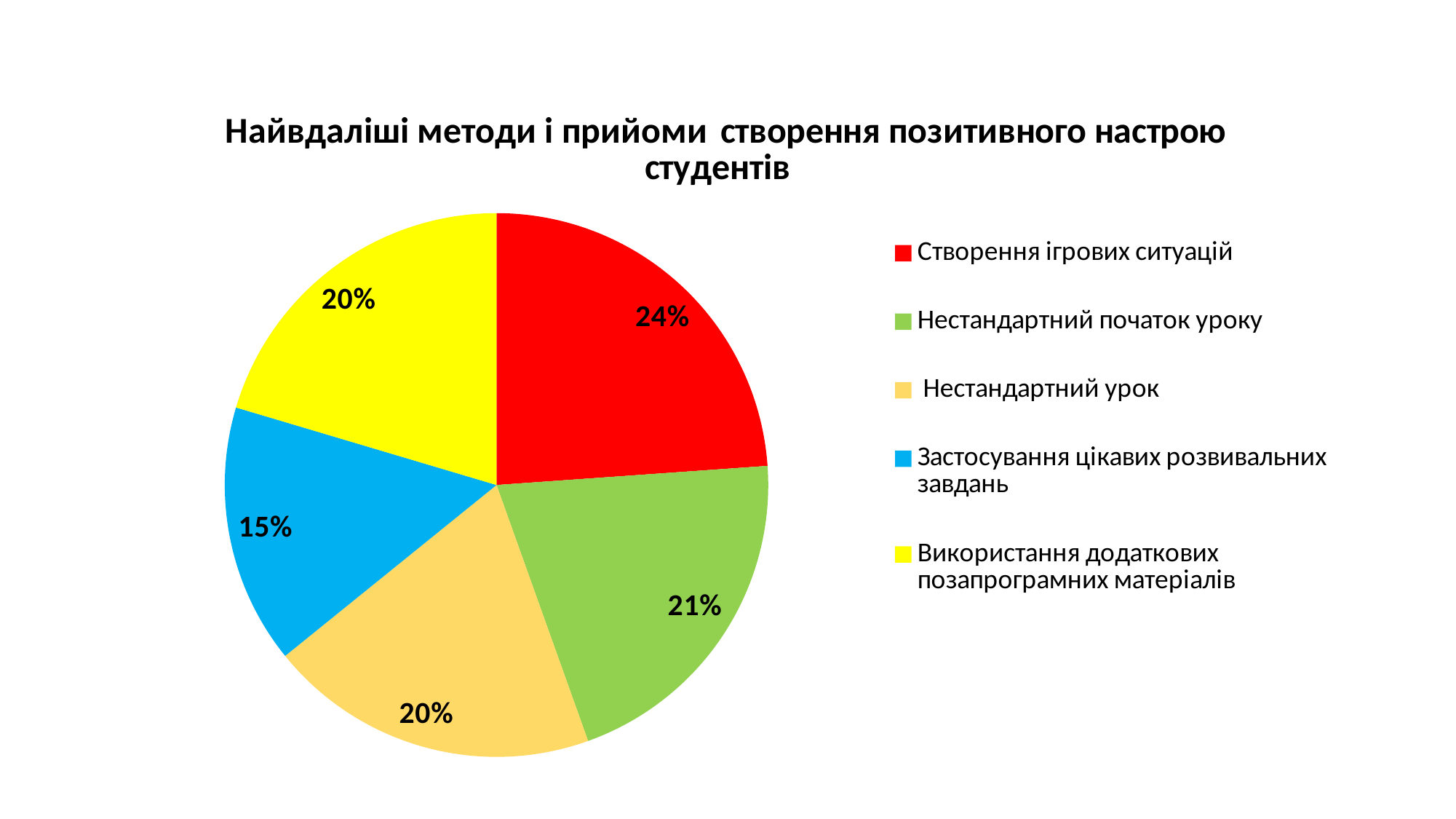
Which is larger: "Нестандартний початок уроку" or "Нестандартний урок"? Нестандартний початок уроку What is the difference between the values for "Створення ігрових ситуацій" and "Застосування цікавих розвивальних завдань"? 9% What is the value shown for "Застосування цікавих розвивальних завдань"? 15% What kind of chart is shown on the slide? Pie chart Which category has the smallest slice of the pie? Застосування цікавих розвивальних завдань What share of the pie does "Створення ігрових ситуацій" have? 24% Which category has the largest slice of the pie? Створення ігрових ситуацій What colour is the slice for "Нестандартний урок"? Light orange What is the value shown for "Використання додаткових позапрограмних матеріалів"? 20% What is the value shown for "Нестандартний початок уроку"? 21% How many categories does the pie chart show? 5 What is the title of the chart? Найвдаліші методи і прийоми створення позитивного настрою студентів